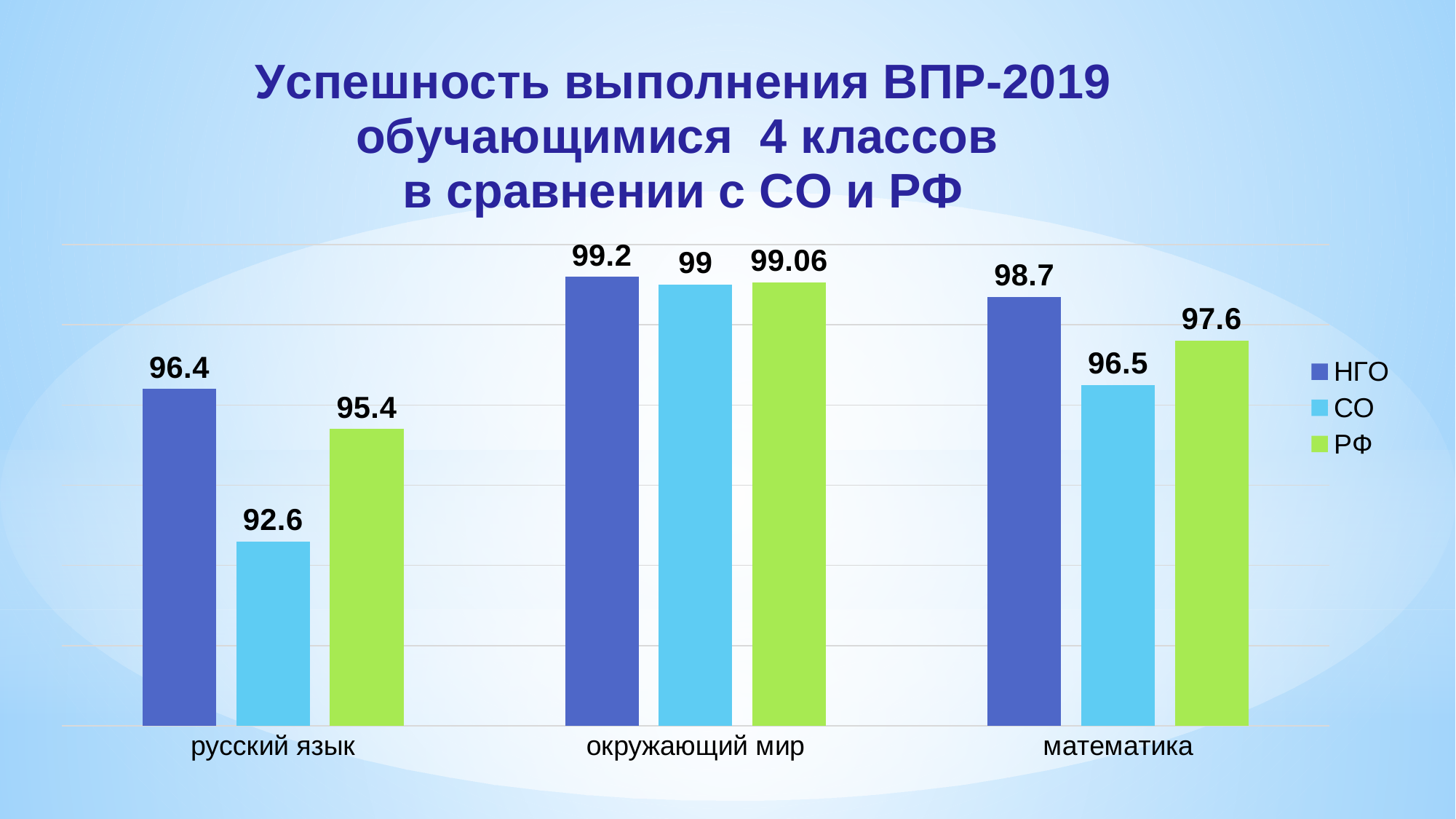
What is the difference between the НГО and РФ values in математика? 1.1 Which subject has the highest value for НГО? окружающий мир What kind of chart is shown on the slide? bar chart What is the value for РФ in окружающий мир? 99.06 Which subject has the lowest value for СО? русский язык What is the value for НГО in русский язык? 96.4 What is the difference between the НГО and СО values in русский язык? 3.8 How many series does the legend list? 3 What is the value for СО in математика? 96.5 How many subject categories are shown on the x axis? 3 Which is larger in математика, the value for СО or the value for РФ? РФ Which series is shown in light green in the legend? РФ